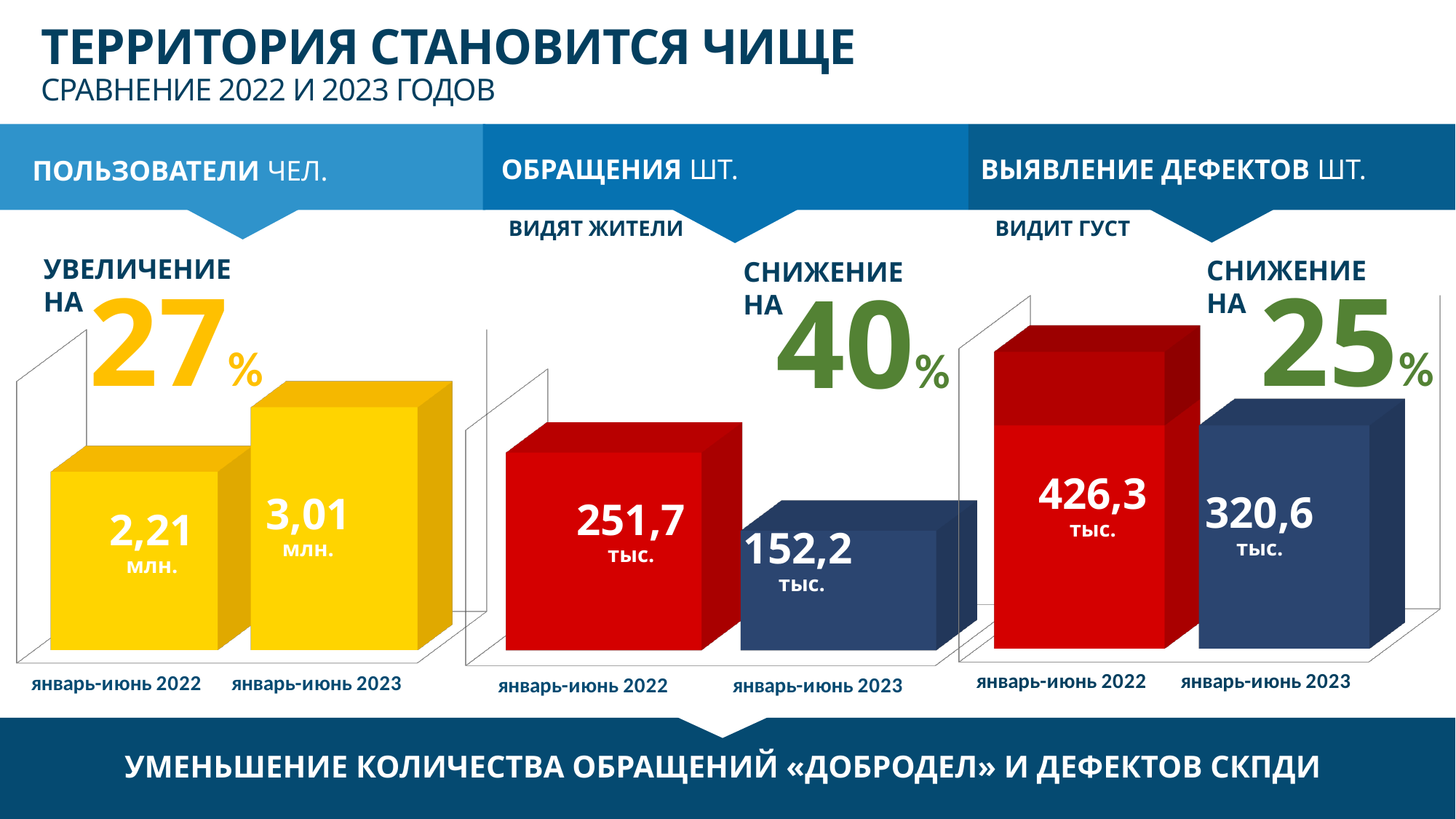
In the "ОБРАЩЕНИЯ ШТ." chart, what is the value for январь-июнь 2023? 152,2 тыс. In the "ОБРАЩЕНИЯ ШТ." chart, what is the difference between the январь-июнь 2022 and январь-июнь 2023 values? 99,5 тыс. How many bars does the "ПОЛЬЗОВАТЕЛИ ЧЕЛ." chart have? 2 In the "ПОЛЬЗОВАТЕЛИ ЧЕЛ." chart, which period has the lower value? январь-июнь 2022 In the "ПОЛЬЗОВАТЕЛИ ЧЕЛ." chart, what is the value for январь-июнь 2023? 3,01 млн. In the "ПОЛЬЗОВАТЕЛИ ЧЕЛ." chart, what is the value for январь-июнь 2022? 2,21 млн. In the "ВЫЯВЛЕНИЕ ДЕФЕКТОВ ШТ." chart, what is the difference between the январь-июнь 2022 and январь-июнь 2023 values? 105,7 тыс. What kind of chart is the "ОБРАЩЕНИЯ ШТ." chart? bar chart In the "ОБРАЩЕНИЯ ШТ." chart, what is the value for январь-июнь 2022? 251,7 тыс. In the "ВЫЯВЛЕНИЕ ДЕФЕКТОВ ШТ." chart, which period has the higher value? январь-июнь 2022 In the "ВЫЯВЛЕНИЕ ДЕФЕКТОВ ШТ." chart, what is the value for январь-июнь 2023? 320,6 тыс. In the "ОБРАЩЕНИЯ ШТ." chart, is the value for январь-июнь 2022 larger or smaller than the value for январь-июнь 2023? larger